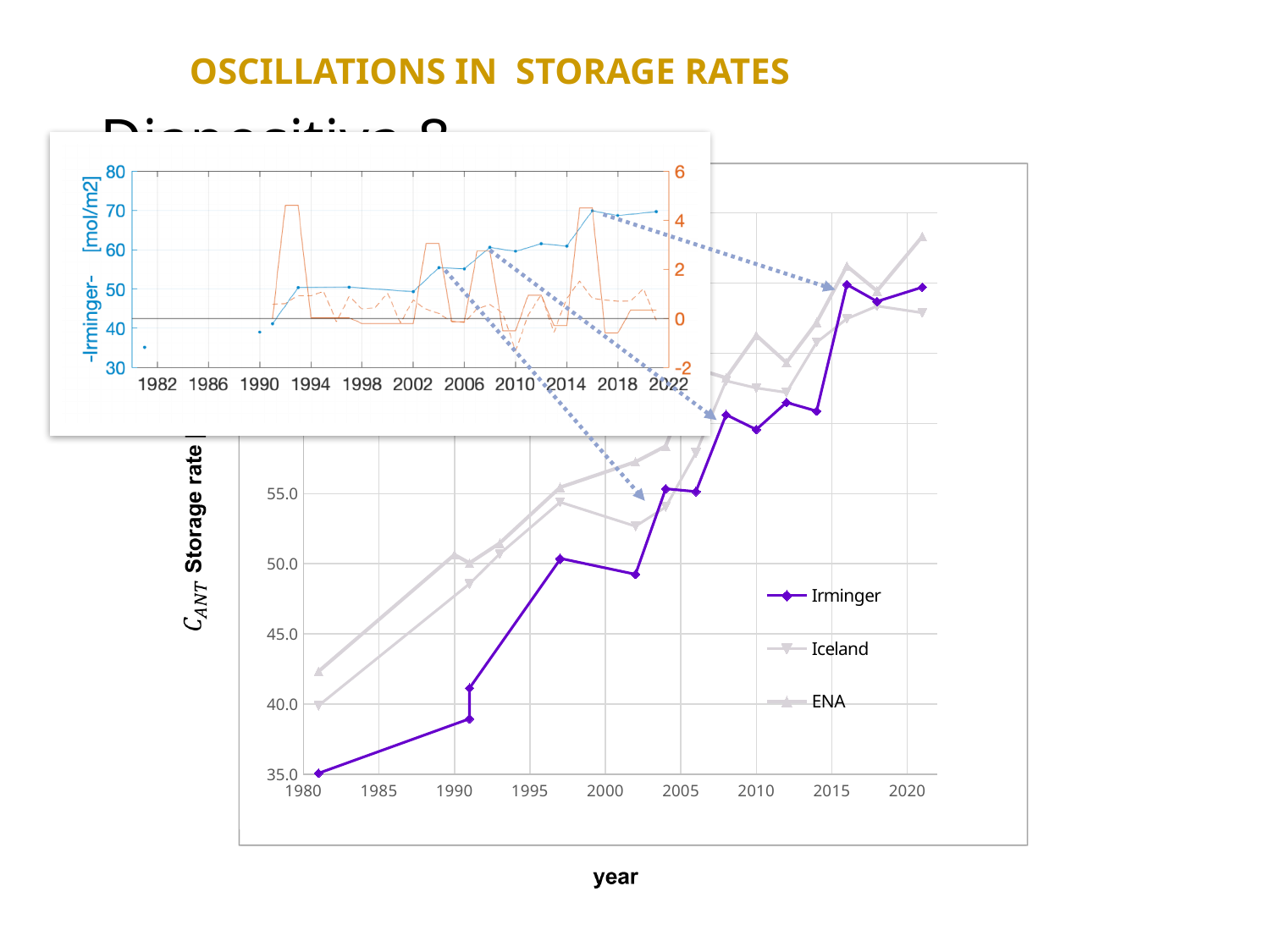
On the inset chart at the top left, does the blue Irminger line rise or fall from 1990 to 2022? rise On the main chart, in 2002, which is larger: the Iceland value or the Irminger value? Iceland On the main chart, which series has the lowest value in 1981? Irminger On the main chart, does the Irminger storage rate rise or fall from 1980 to 2020 overall? rise On the inset chart at the top left, is the Irminger value in 2021 greater or less than 60 mol/m2? greater On the main chart, how many series does the legend list? 3 On the main chart, what is the label of the x axis? year On the main chart, in 2021, which is larger: the ENA value or the Iceland value? ENA On the main chart, is the Irminger value in 2016 greater or less than 55.0? greater On the main chart, what kind of chart is used to show the storage rates? line chart On the main chart, is the Irminger value in 1981 greater or less than 40.0? less